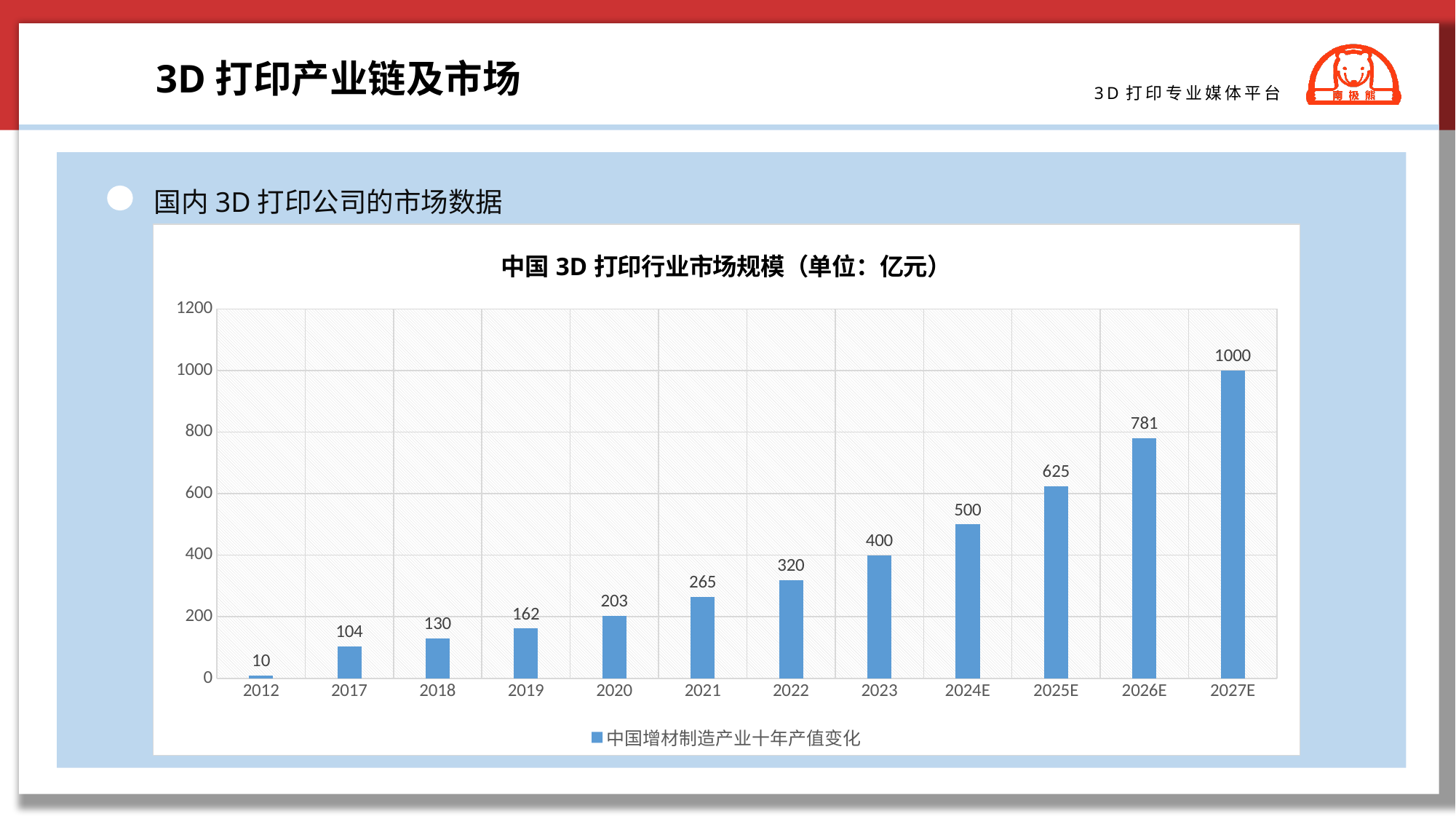
What is the value for 2020? 203 Which is larger, the value for 2019 or the value for 2021? 2021 Which year has the highest value? 2027E What is the value for 2025E? 625 Which year has the lowest value? 2012 How many series does the legend list? 1 How many years are shown on the x axis? 12 Do the values rise or fall from 2012 to 2027E? rise What is the difference between the values for 2023 and 2022? 80 Is the value for 2026E greater or less than 600? greater What kind of chart is shown? bar chart What is the title of the chart? 中国 3D 打印行业市场规模（单位：亿元）